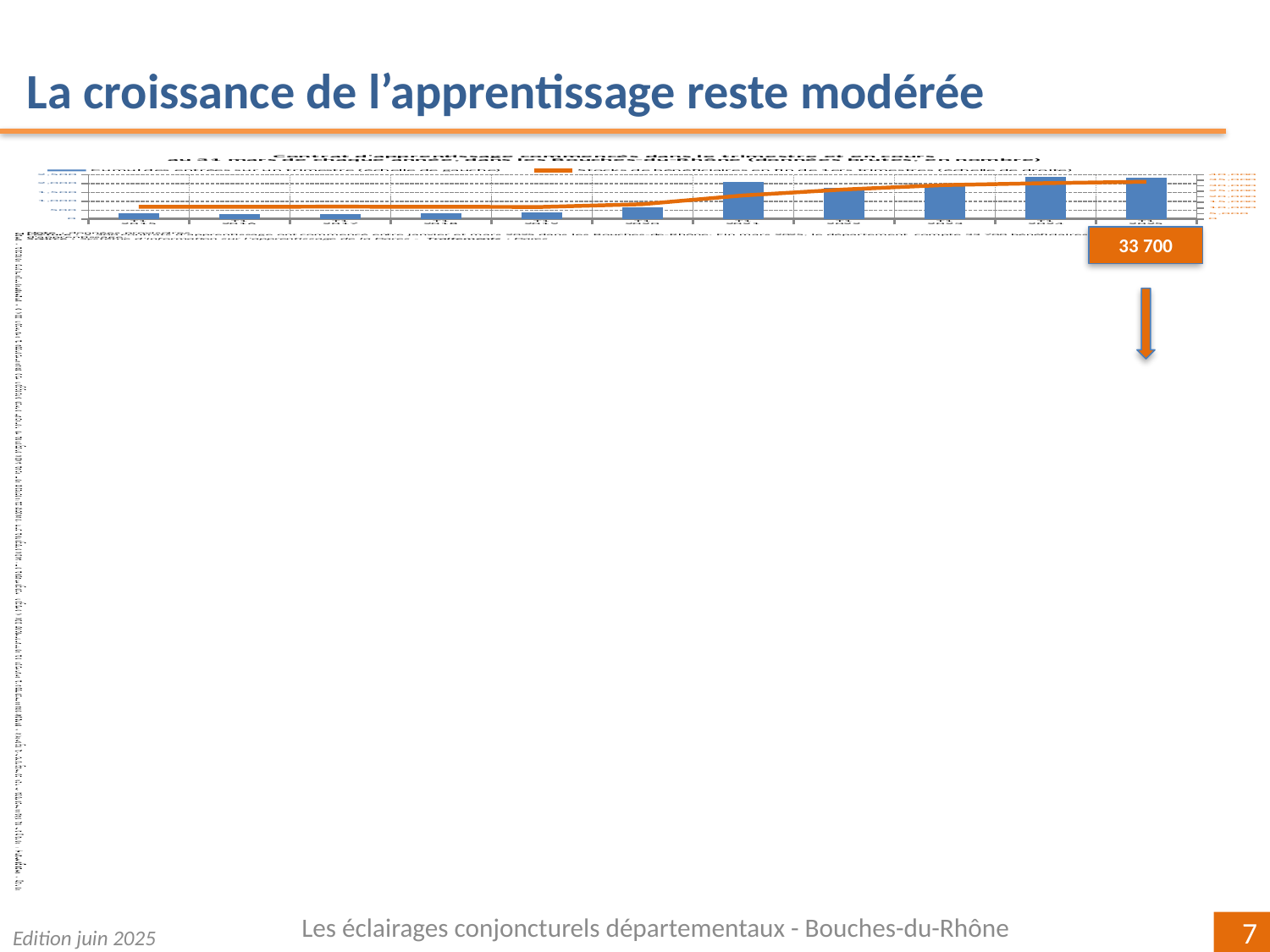
Which is larger, the bar for 2016 or the bar for 2021? 2021 Which is larger, the first bar on the left or the last bar on the right? the last bar on the right Which is larger, the bar for 2020 or the bar for 2022? 2022 What kind of chart is shown on the slide? a bar chart with a line overlay What colour are the bars in the chart? blue What value is shown in the orange callout box to the right of the chart? 33 700 Does the orange line rise or fall from left to right across the chart? rise How many bars are plotted along the x axis of the chart? 11 Do the bar values generally rise or fall from left to right along the x axis? rise How many series does the chart legend list? 2